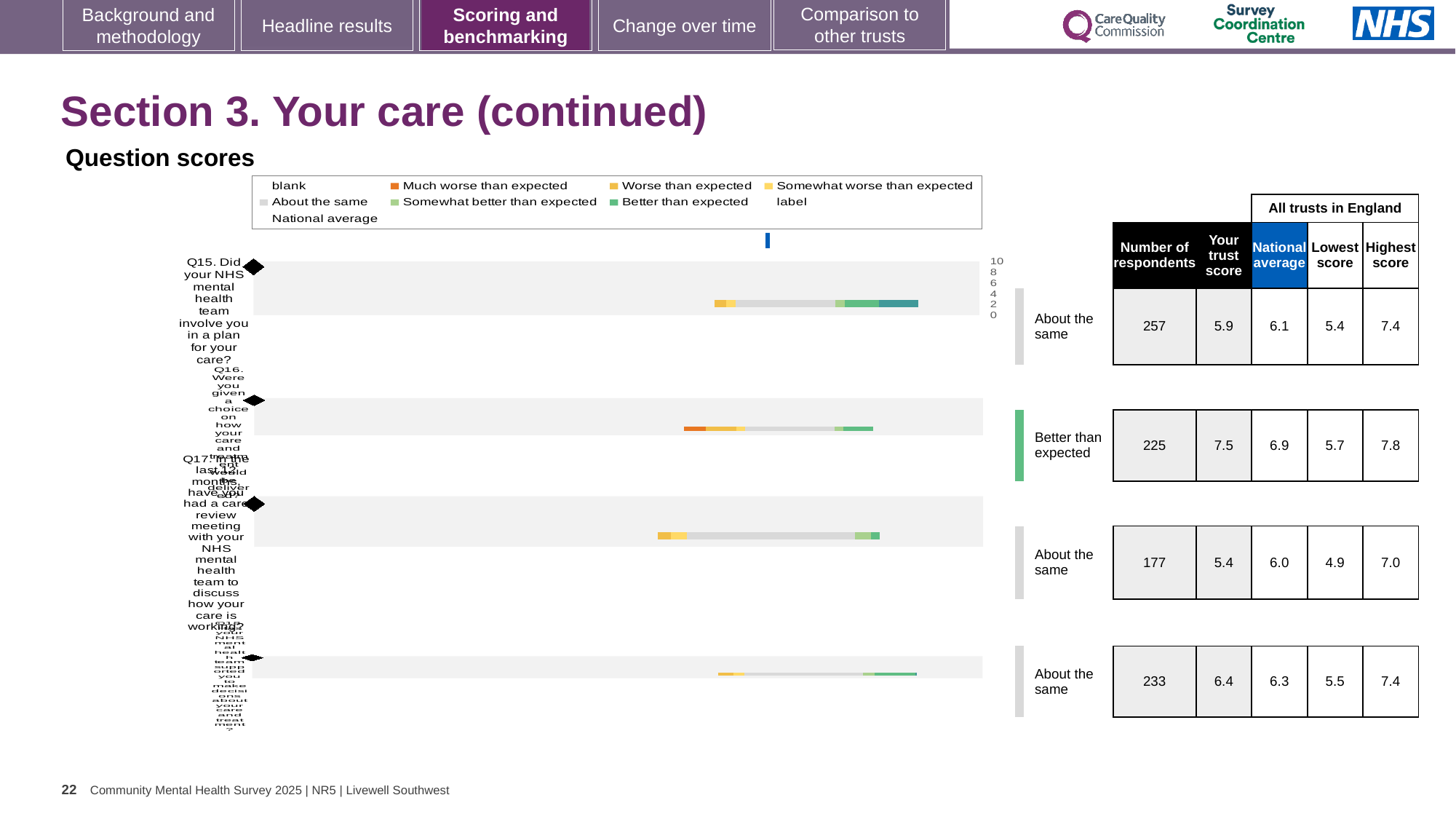
What is the difference between the trust score and the national average for Q16? 0.6 How many question rows (bars) are plotted in the question scores chart? 4 What benchmark category is shown for Q16? Better than expected Which of the four questions shown has the highest 'Your trust score'? Q16 What is the highest score across all trusts in England for Q17? 7.0 What is the national average score for Q15? 6.1 Which of the four questions shown has the lowest 'Your trust score'? Q17 What is the 'Your trust score' for Q17 (In the last 12 months, have you had a care review meeting)? 5.4 What is the 'Your trust score' for Q15 (Did your NHS mental health team involve you in a plan for your care?)? 5.9 For Q17, which is larger: the trust score or the national average? national average How many respondents answered Q16 (Were you given a choice on how your care would be delivered)? 225 What kind of chart is used to show the question scores on this slide? bar chart